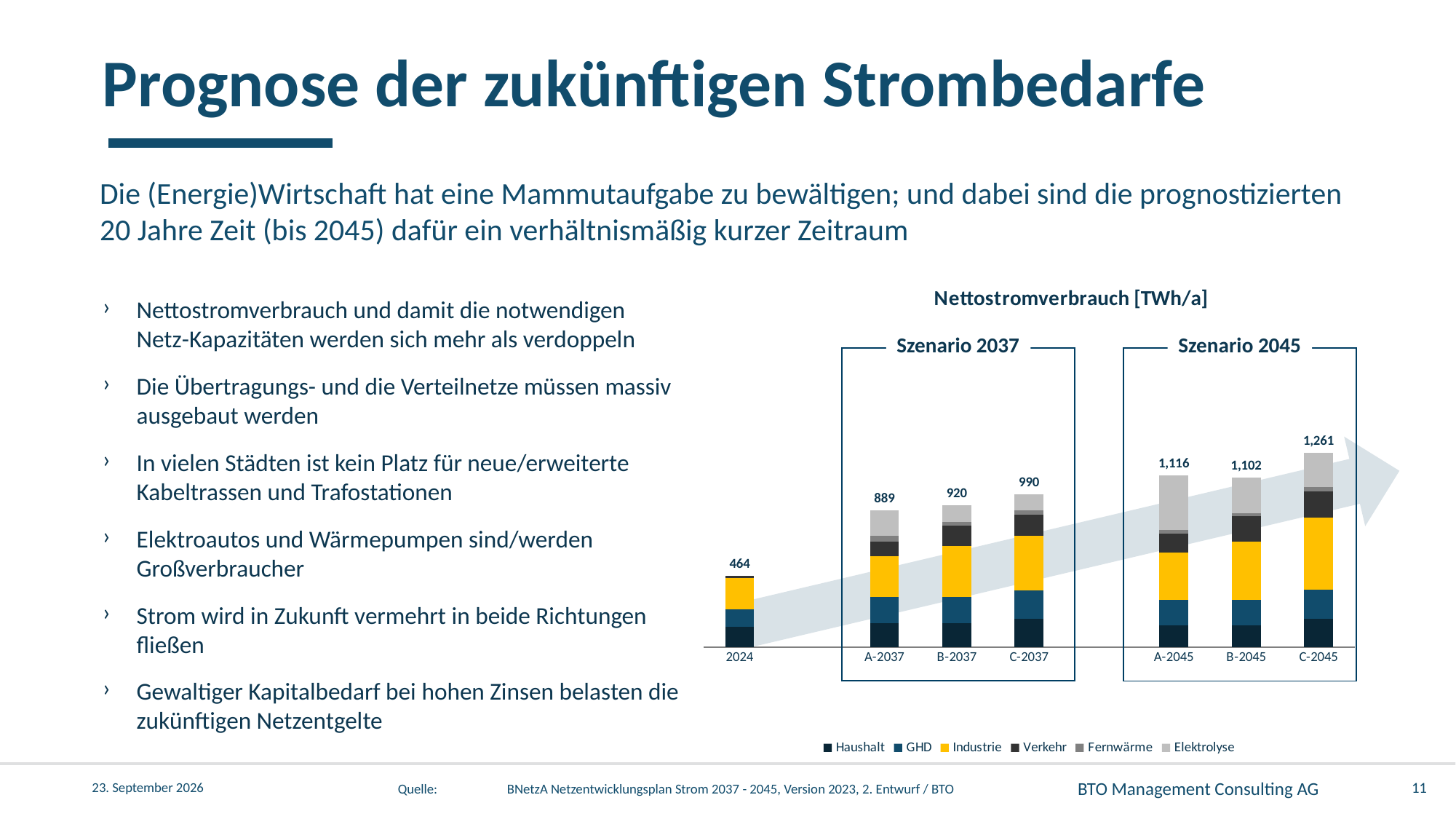
What is the title of the chart? Nettostromverbrauch [TWh/a] What is the difference between the totals for A-2045 and B-2045? 14 Which category has the lowest total net electricity consumption? 2024 Which category has the highest total net electricity consumption? C-2045 What kind of chart is shown on the slide? Stacked bar chart How many series does the legend list? 6 What is the total value shown for the C-2045 bar? 1,261 What is the total value shown for B-2037? 920 How many categories (bars) are shown on the x axis? 7 Which has a larger total, A-2037 or C-2037? C-2037 What is the total net electricity consumption shown for 2024? 464 What is the difference between the totals for C-2037 and 2024? 526